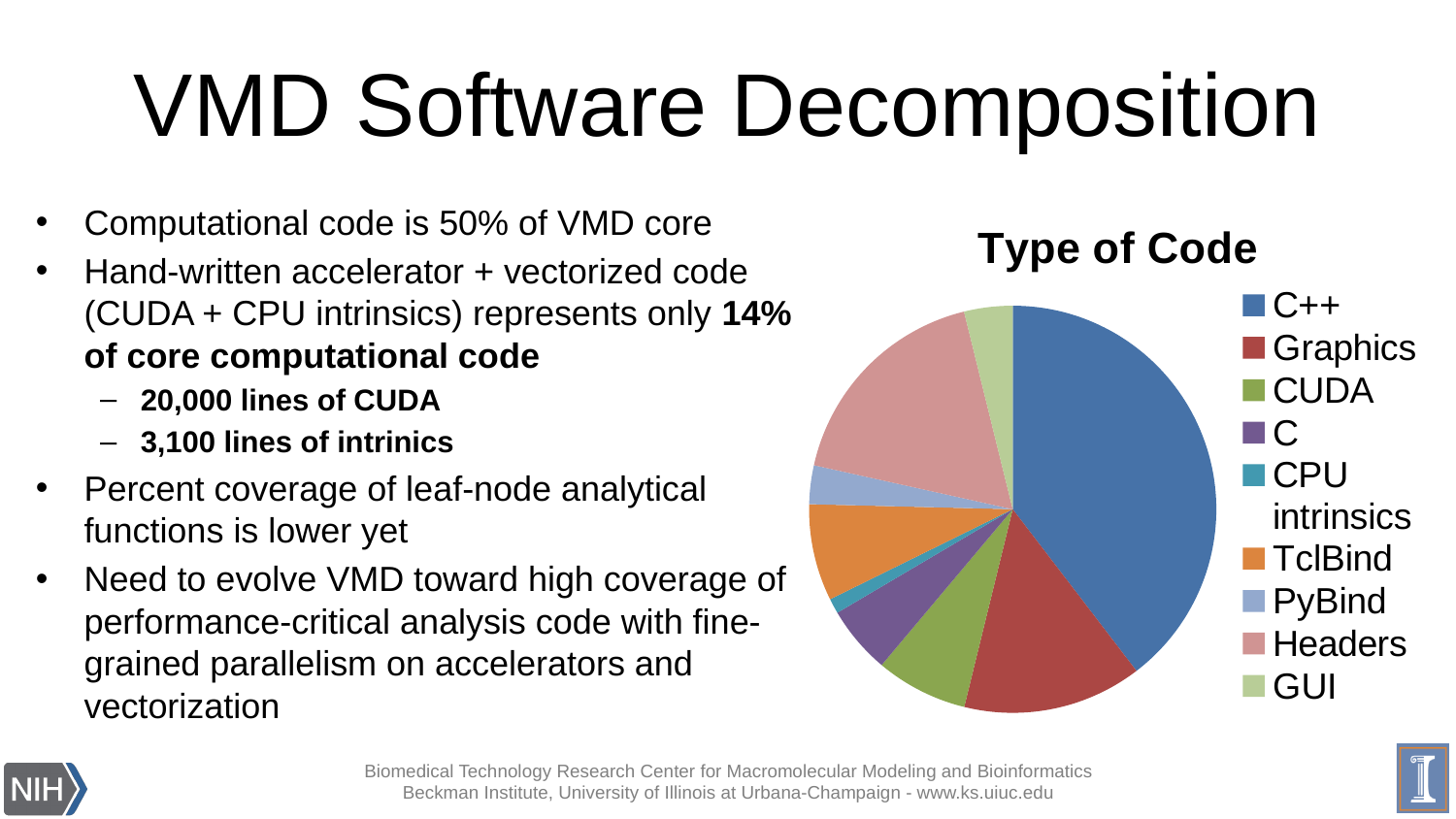
Which slice is larger, Graphics or CUDA? Graphics What colour is the C++ slice in the pie chart? Blue Which type of code has the smallest slice of the pie? CPU intrinsics Which slice is larger, Headers or PyBind? Headers How many categories does the legend of the pie chart list? 9 What is the title of the chart? Type of Code Which slice is larger, Headers or GUI? Headers What kind of chart is shown on the slide? Pie chart Which type of code has the largest slice of the pie? C++ Which legend entry is listed last in the pie chart's legend? GUI